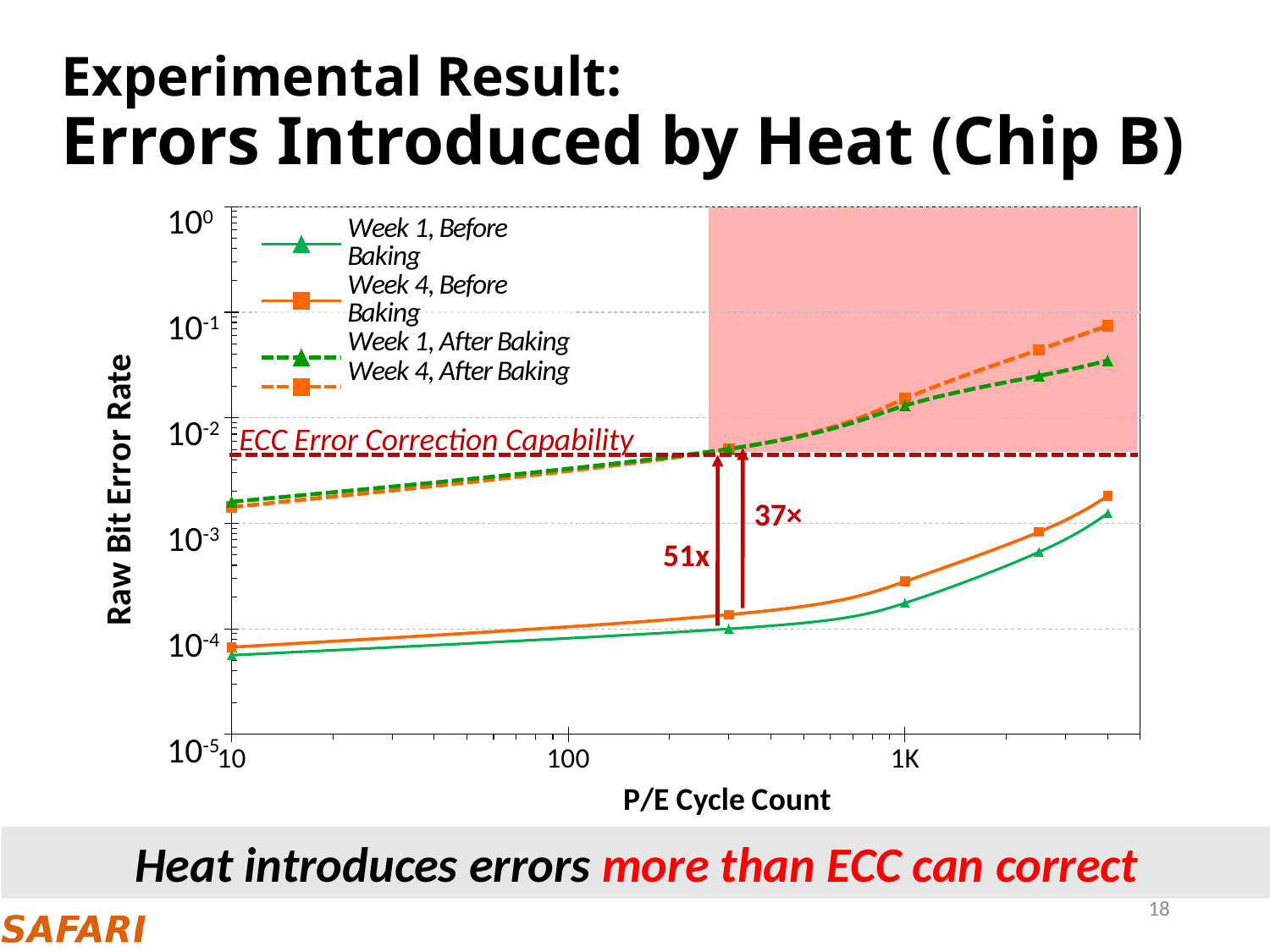
Is the value for Week 1, Before Baking at 100 P/E cycles greater or less than 10^-3? less What does the horizontal dashed red line in the chart represent? ECC Error Correction Capability Do the raw bit error rates rise or fall as the P/E cycle count increases? rise Which series reaches the highest raw bit error rate at the rightmost P/E cycle count? Week 4, After Baking Is the value for Week 4, After Baking at 1K P/E cycles greater or less than 10^-2? greater How many series does the chart's legend list? 4 Is the value for Week 4, Before Baking at 1K P/E cycles greater or less than 10^-3? less Which series are listed in the chart's legend? Week 1, Before Baking; Week 4, Before Baking; Week 1, After Baking; Week 4, After Baking At 1K P/E cycles, which has the higher raw bit error rate: Week 4, After Baking or Week 4, Before Baking? Week 4, After Baking What kind of chart is shown on the slide? line chart What two multiplication factors are annotated on the arrows in the chart? 51x and 37× At the rightmost P/E cycle count, which has the higher raw bit error rate: Week 4, Before Baking or Week 1, Before Baking? Week 4, Before Baking